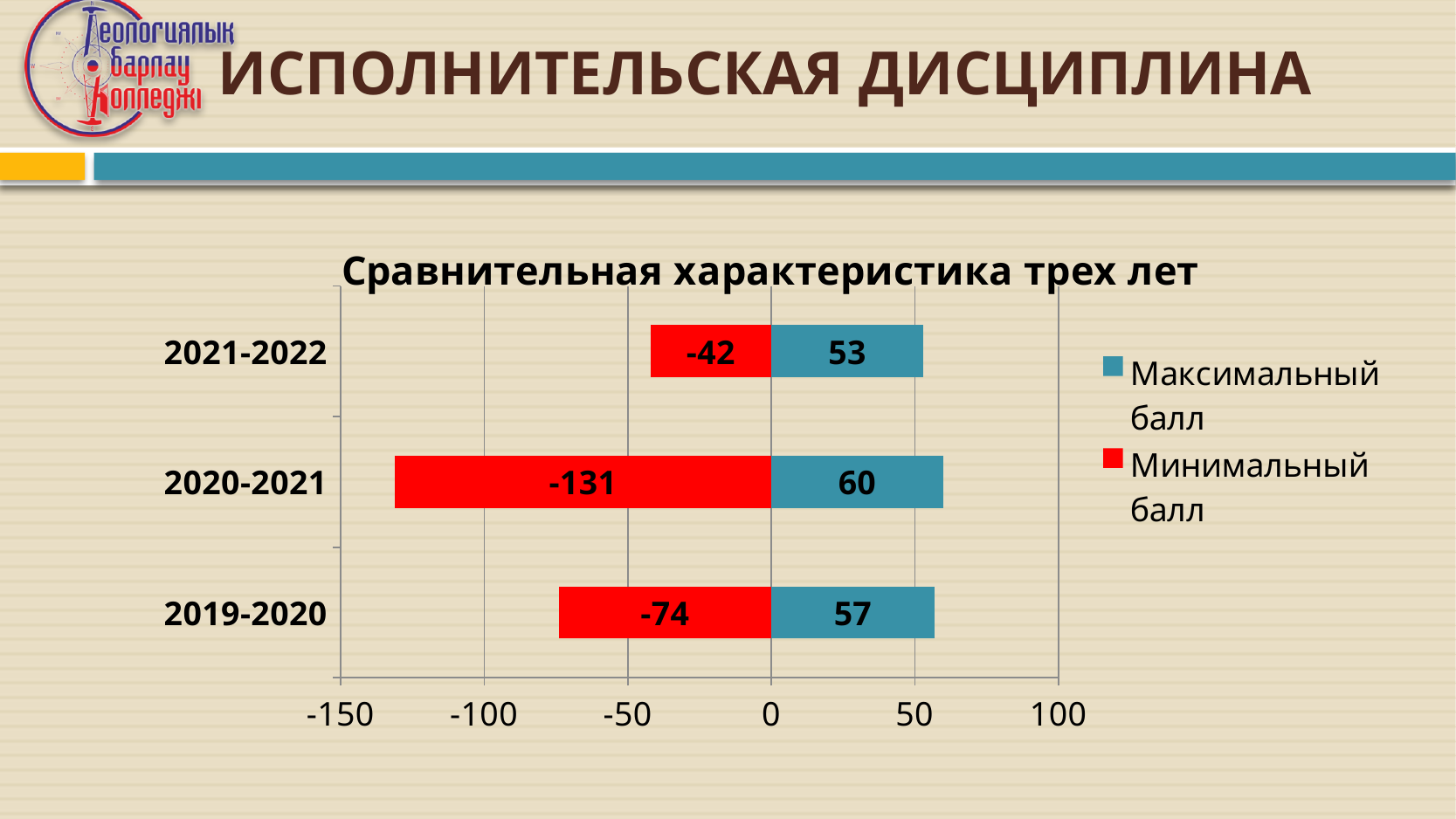
How many year categories are shown on the chart? 3 Which is larger, the Максимальный балл for 2019-2020 or for 2021-2022? 2019-2020 What is the value of Минимальный балл for 2019-2020? -74 What is the difference between the Максимальный балл for 2020-2021 and 2021-2022? 7 Which colour represents Минимальный балл in the chart? red What is the title of the chart? Сравнительная характеристика трех лет Which year has the lowest Минимальный балл? 2020-2021 Which year has the highest Максимальный балл? 2020-2021 What is the value of Максимальный балл for 2020-2021? 60 What kind of chart is shown on the slide? bar chart What is the value of Минимальный балл for 2021-2022? -42 How many series does the legend list? 2